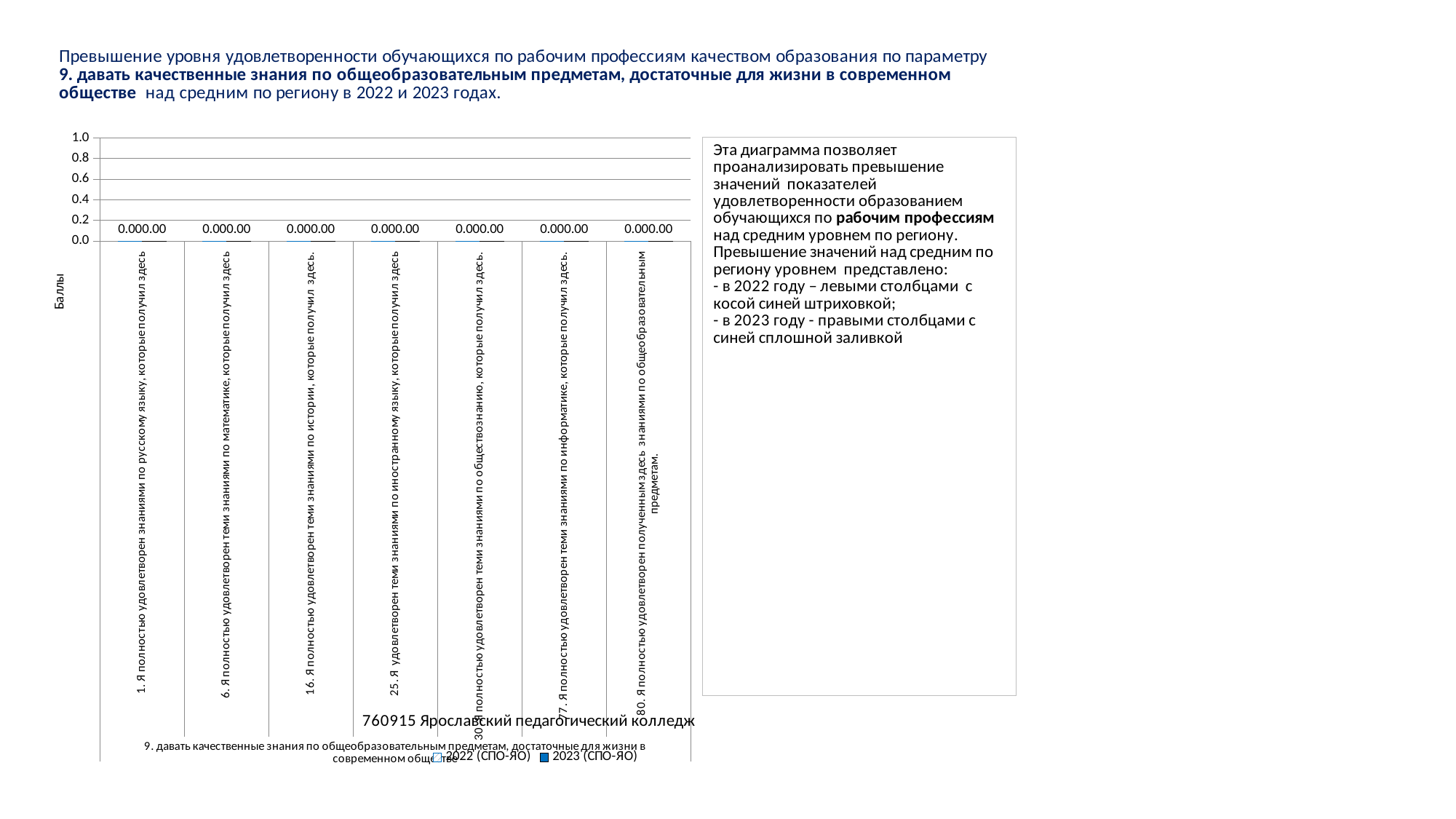
What kind of chart is shown on the slide? bar chart What are the two series named in the chart legend? 2022 (СПО-ЯО) and 2023 (СПО-ЯО) Is the value for category '6. Я полностью удовлетворен теми знаниями по математике, которые получил здесь' greater or less than 0.4? less What is the highest tick value shown on the vertical axis of the chart? 1.0 How many series does the chart legend list? 2 What is the title of the vertical axis of the chart? Баллы How many categories are shown along the x axis of the chart? 7 Is the value for category '1. Я полностью удовлетворен знаниями по русскому языку, которые получил здесь' greater or less than 0.2? less Is the value for category '80. Я полностью удовлетворен полученным здесь знаниями по общеобразовательным предметам' greater or less than 0.2? less